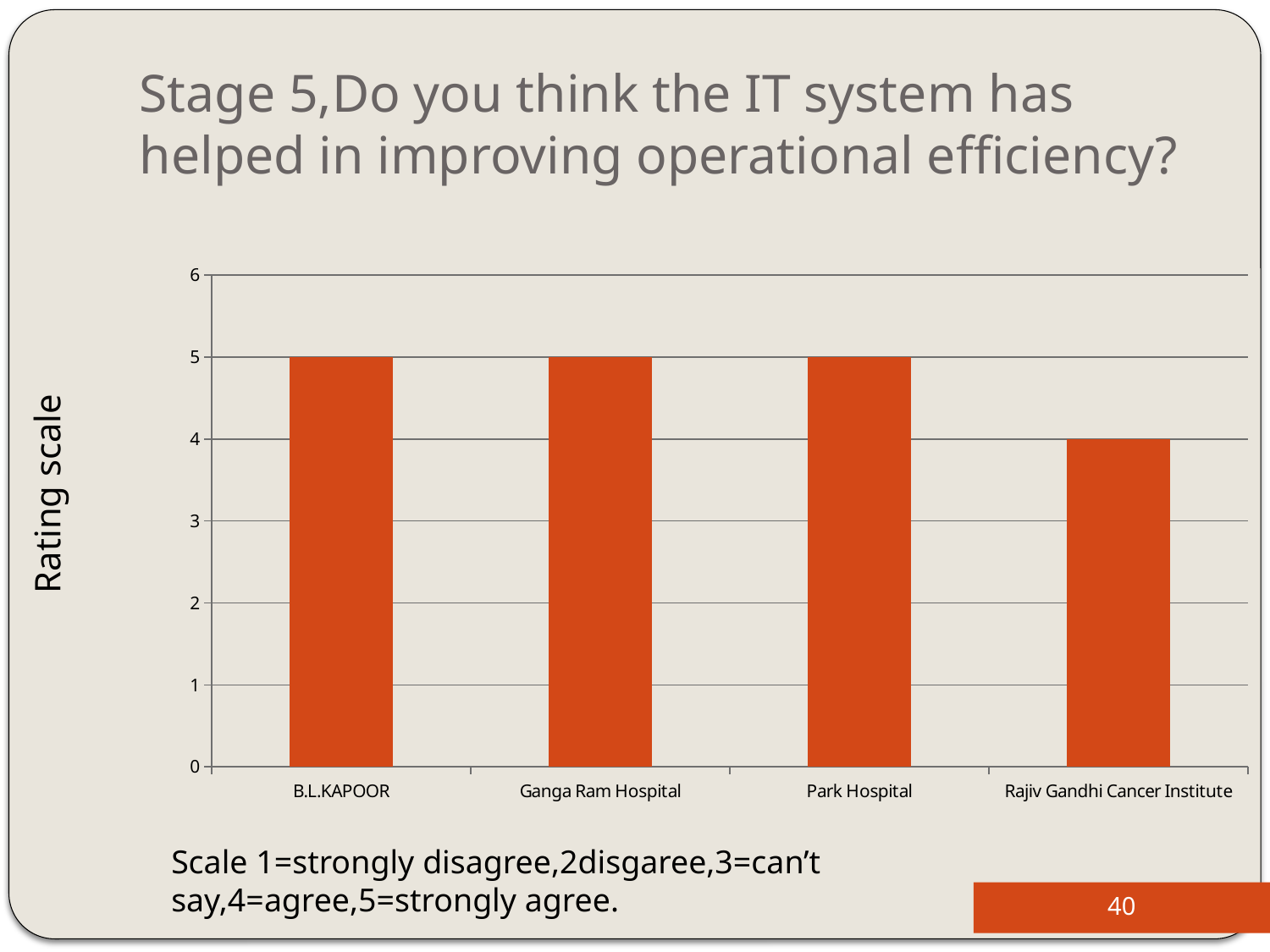
Which has a higher rating, Ganga Ram Hospital or Rajiv Gandhi Cancer Institute? Ganga Ram Hospital Which hospital has the lowest rating? Rajiv Gandhi Cancer Institute Is the value for Rajiv Gandhi Cancer Institute greater or less than 3? greater What kind of chart is shown on the slide? bar chart What is the highest value shown on the vertical axis? 6 What is the rating for Rajiv Gandhi Cancer Institute? 4 What is the label of the vertical axis? Rating scale What is the rating for B.L.KAPOOR? 5 How many hospitals are shown on the chart? 4 What is the rating for Park Hospital? 5 What is the rating for Ganga Ram Hospital? 5 What is the difference between the rating for Park Hospital and the rating for Rajiv Gandhi Cancer Institute? 1